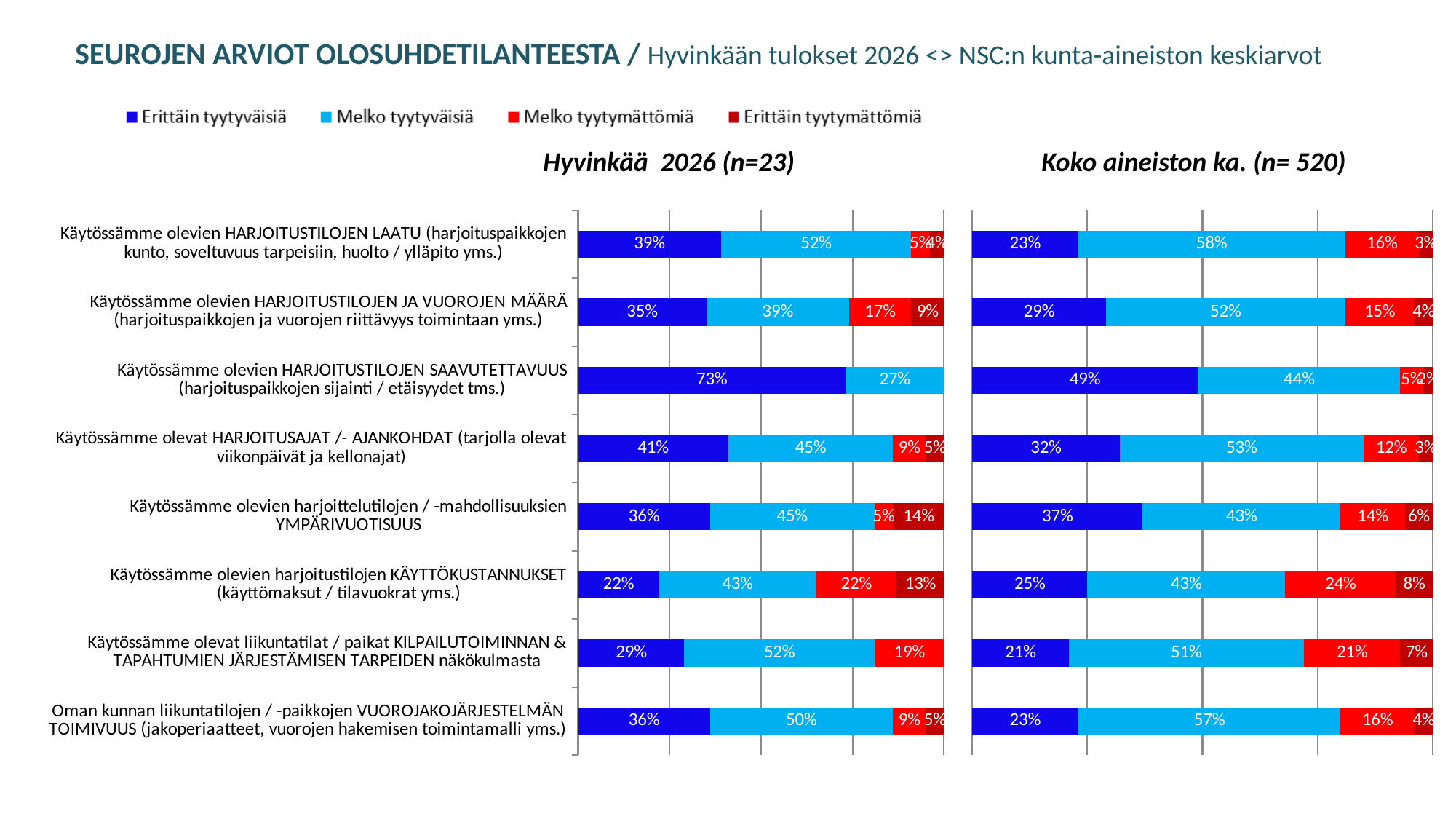
How many categories (rows) does the Hyvinkää 2026 (n=23) chart show? 8 What is the difference between the 'Erittäin tyytyväisiä' share for HARJOITUSTILOJEN SAAVUTETTAVUUS in the Hyvinkää 2026 chart and in the Koko aineiston ka. chart? 24 percentage points How many series does the legend list? 4 In the Hyvinkää 2026 (n=23) chart, what is the 'Erittäin tyytyväisiä' share for HARJOITUSTILOJEN SAAVUTETTAVUUS? 73% What type of chart is used for the Koko aineiston ka. (n= 520) data? Stacked bar chart Which colour represents 'Erittäin tyytymättömiä' in the legend? Dark red In the Koko aineiston ka. (n= 520) chart, what is the 'Melko tyytyväisiä' share for HARJOITUSTILOJEN LAATU? 58% In the Koko aineiston ka. (n= 520) chart, what is the 'Erittäin tyytymättömiä' share for harjoitustilojen KÄYTTÖKUSTANNUKSET? 8% Is the 'Erittäin tyytyväisiä' share for HARJOITUSTILOJEN JA VUOROJEN MÄÄRÄ larger in the Hyvinkää 2026 chart or in the Koko aineiston ka. chart? Hyvinkää 2026 In the Hyvinkää 2026 (n=23) chart, which category has the lowest 'Erittäin tyytyväisiä' share? Käytössämme olevien harjoitustilojen KÄYTTÖKUSTANNUKSET In the Hyvinkää 2026 (n=23) chart, what is the 'Melko tyytymättömiä' share for harjoitustilojen KÄYTTÖKUSTANNUKSET? 22% In the Hyvinkää 2026 (n=23) chart, which category has the highest 'Erittäin tyytyväisiä' share? Käytössämme olevien HARJOITUSTILOJEN SAAVUTETTAVUUS